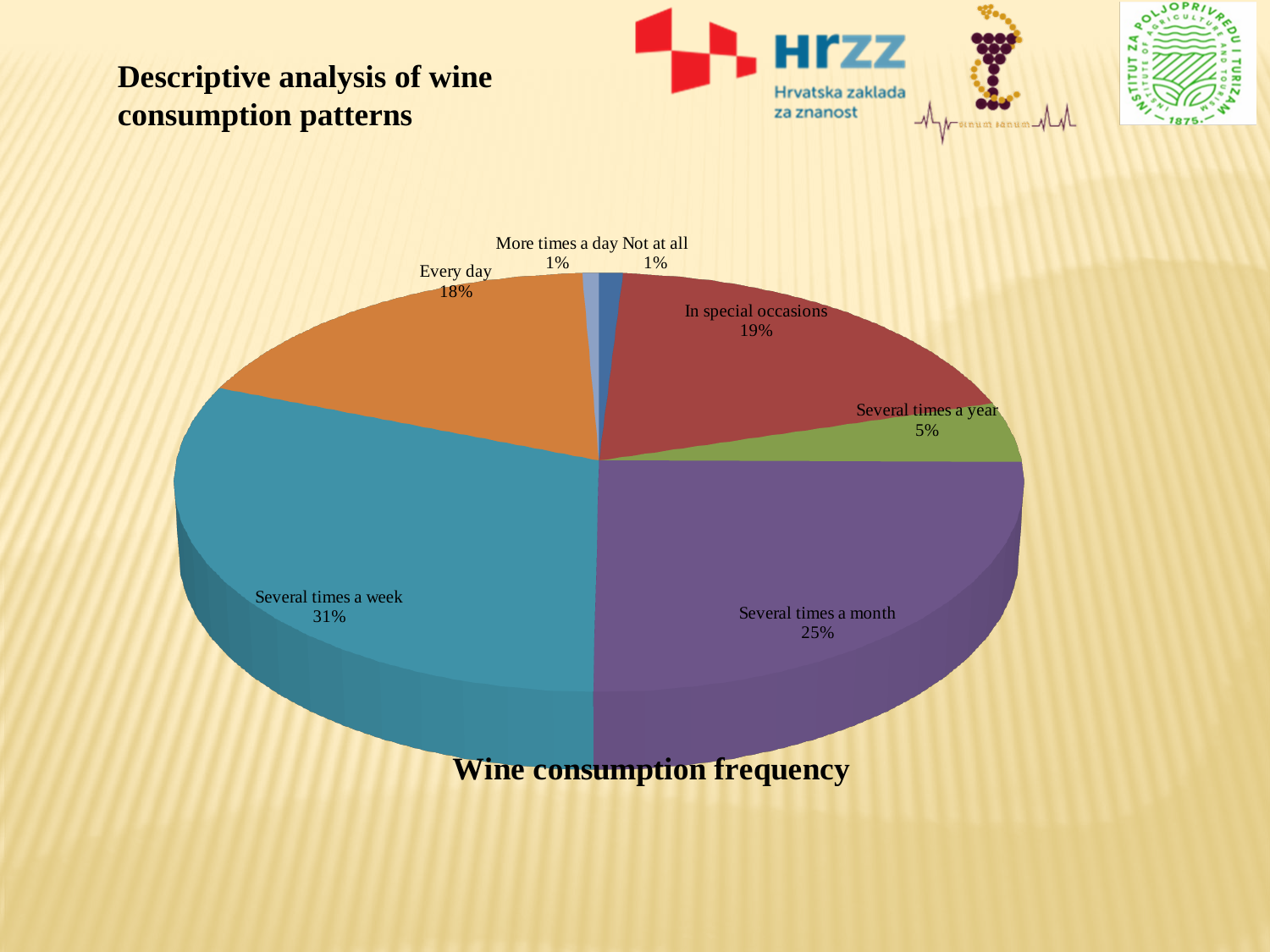
What is the value for 'Not at all'? 1% What is the value for 'In special occasions'? 19% What is the value for 'Several times a month'? 25% What is the value for 'Several times a year'? 5% Which is larger, the share for 'In special occasions' or the share for 'Every day'? In special occasions Which category has the largest share of the pie? Several times a week What kind of chart is shown on the slide? Pie chart What share of the pie does 'Several times a week' represent? 31% How many categories are shown in the pie chart? 7 What is the title of the chart? Wine consumption frequency What is the difference between the shares for 'Several times a week' and 'Several times a month'? 6% What is the value for 'Every day'? 18%